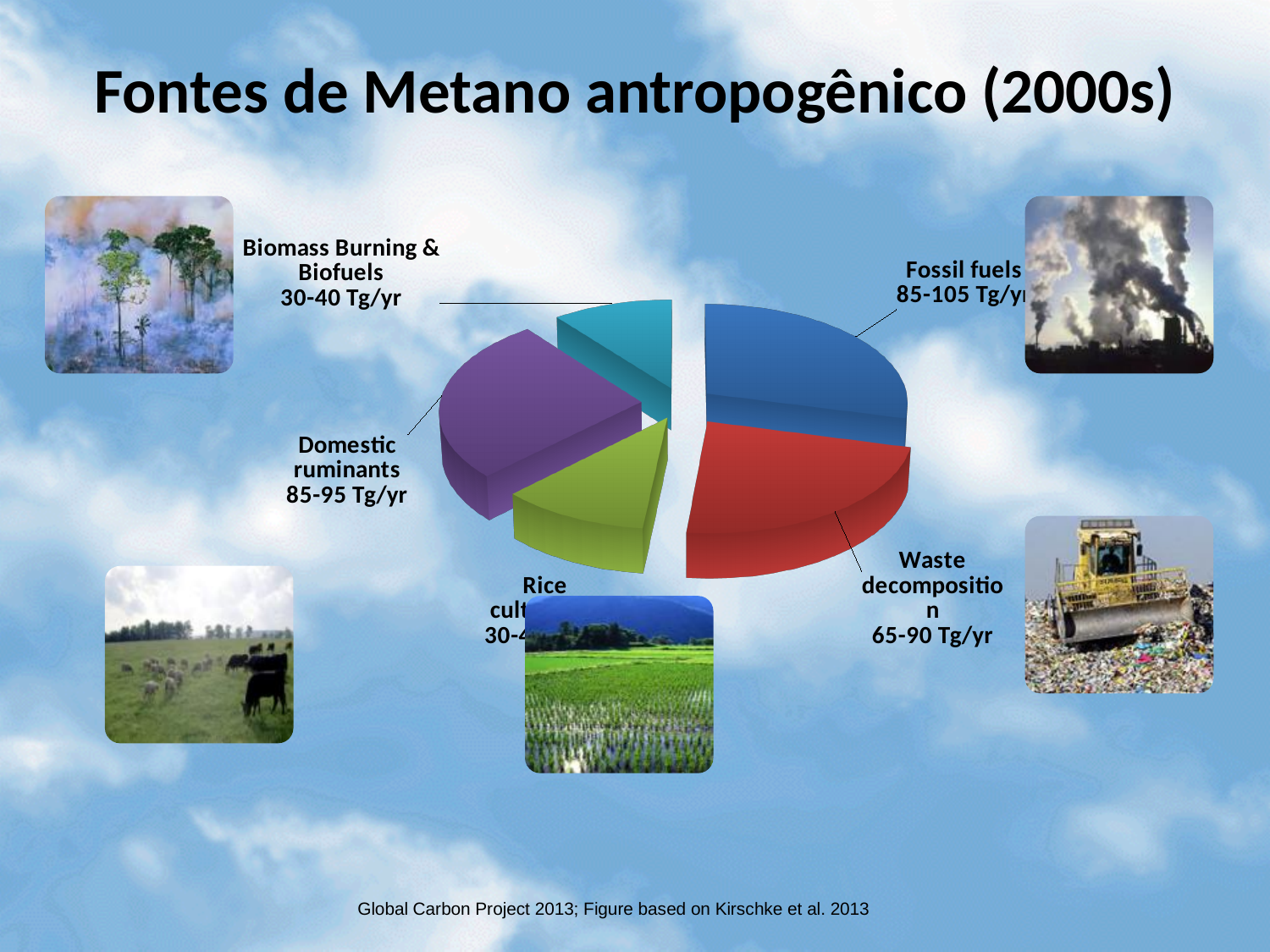
What colour is the Fossil fuels slice? blue Which is larger, the slice for Domestic ruminants or the slice for Biomass Burning & Biofuels? Domestic ruminants What is the value labelled for Fossil fuels? 85-105 Tg/yr What colour is the Domestic ruminants slice? purple What is the value labelled for Waste decomposition? 65-90 Tg/yr Which source has the largest slice of the pie? Fossil fuels What is the value labelled for Biomass Burning & Biofuels? 30-40 Tg/yr How many slices does the pie chart have? 5 Which is larger, the slice for Fossil fuels or the slice for Biomass Burning & Biofuels? Fossil fuels What kind of chart is shown on the slide? pie chart What is the value labelled for Domestic ruminants? 85-95 Tg/yr